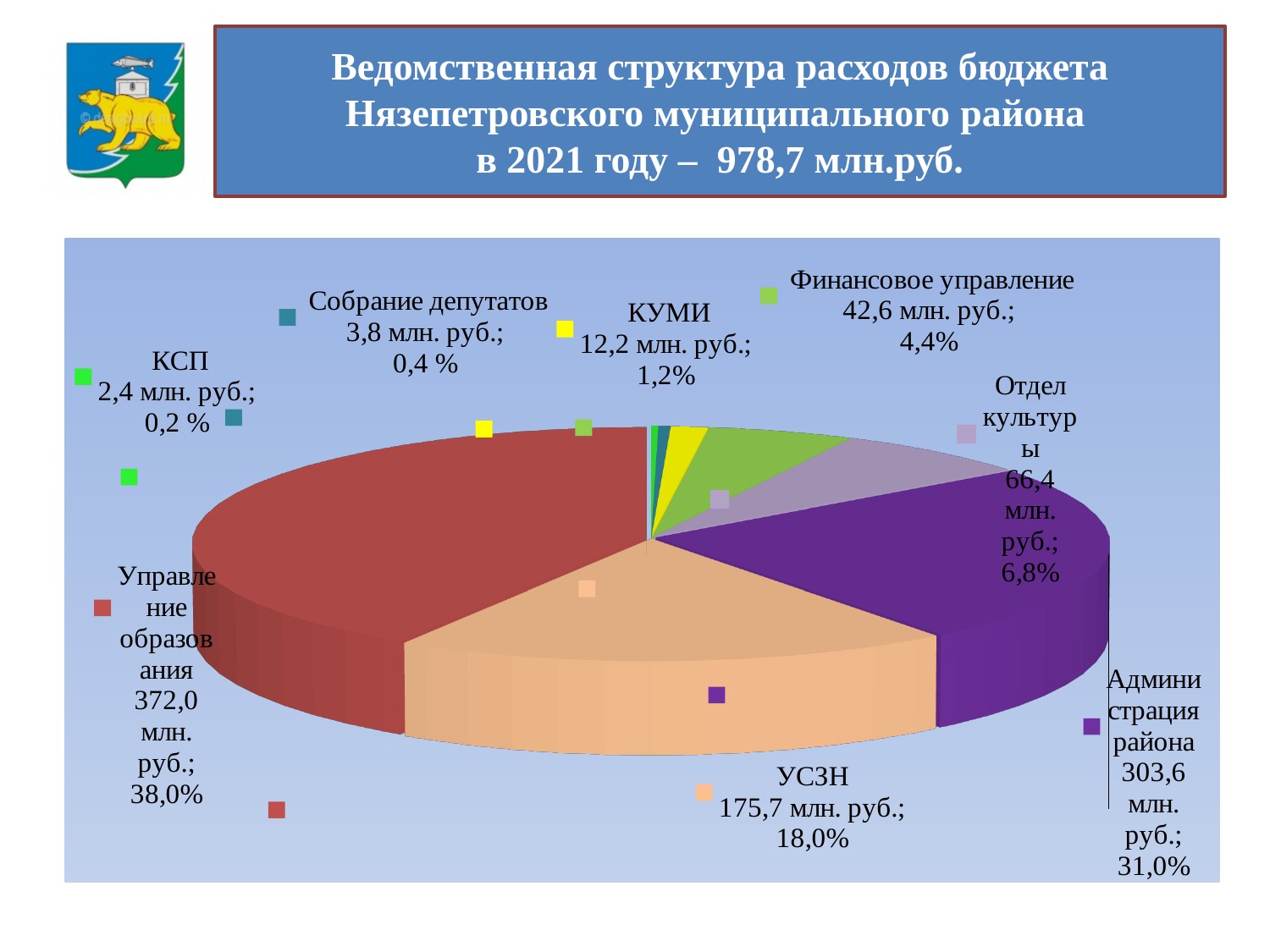
Какой общий объём расходов бюджета указан в заголовке слайда? 978,7 млн.руб. Какую долю расходов составляет «Отдел культуры»? 6,8% Что больше: расходы по «КУМИ» или по «Собранию депутатов»? КУМИ Сколько секторов (категорий) содержит круговая диаграмма? 8 Какую долю расходов составляет «Администрация района»? 31,0% Какова сумма расходов по категории «УСЗН»? 175,7 млн. руб. На сколько млн. руб. расходы «Управления образования» больше расходов «Администрации района»? 68,4 млн. руб. Какая категория имеет наименьшую долю расходов? КСП Какова сумма расходов по категории «Управление образования»? 372,0 млн. руб. Какова сумма расходов по категории «Финансовое управление»? 42,6 млн. руб. Какой тип диаграммы показан на слайде? Круговая диаграмма Какая категория имеет наибольшую долю расходов? Управление образования